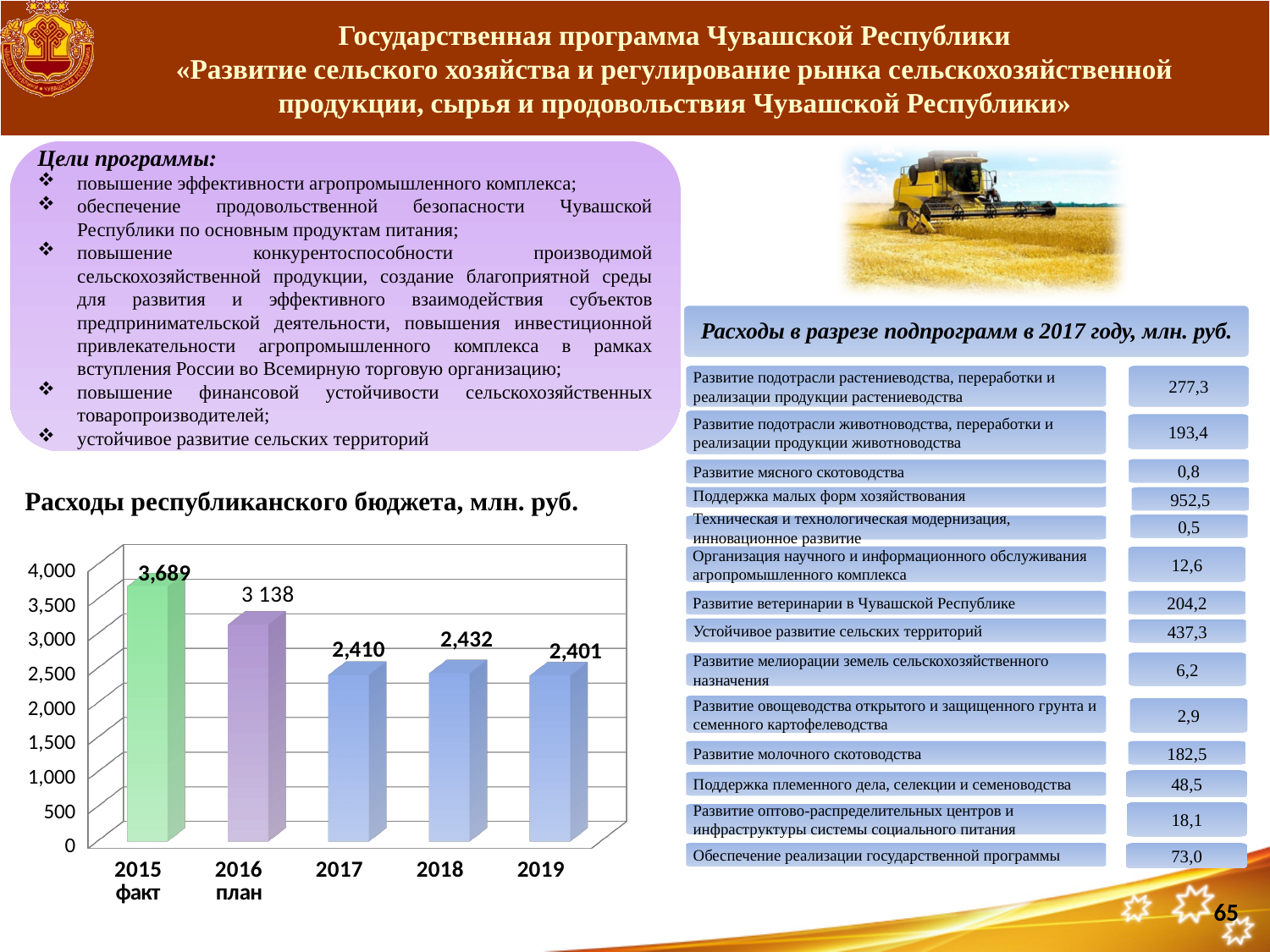
Which category has the lowest value in the chart? 2019 What is the value for 2016 план in the chart? 3 138 What is the value for 2017 in the chart? 2,410 Which category has the highest value in the chart? 2015 факт What kind of chart is shown on the slide? bar chart Do the values rise or fall from 2015 факт to 2017? fall What is the value for 2019 in the chart? 2,401 What is the difference between the values for 2015 факт and 2016 план? 551 Which is larger, the value for 2018 or the value for 2019? 2018 How many categories are shown on the x axis of the chart? 5 What is the value for 2015 факт in the chart 'Расходы республиканского бюджета, млн. руб.'? 3,689 Is the value for 2016 план greater or less than 3,000? greater